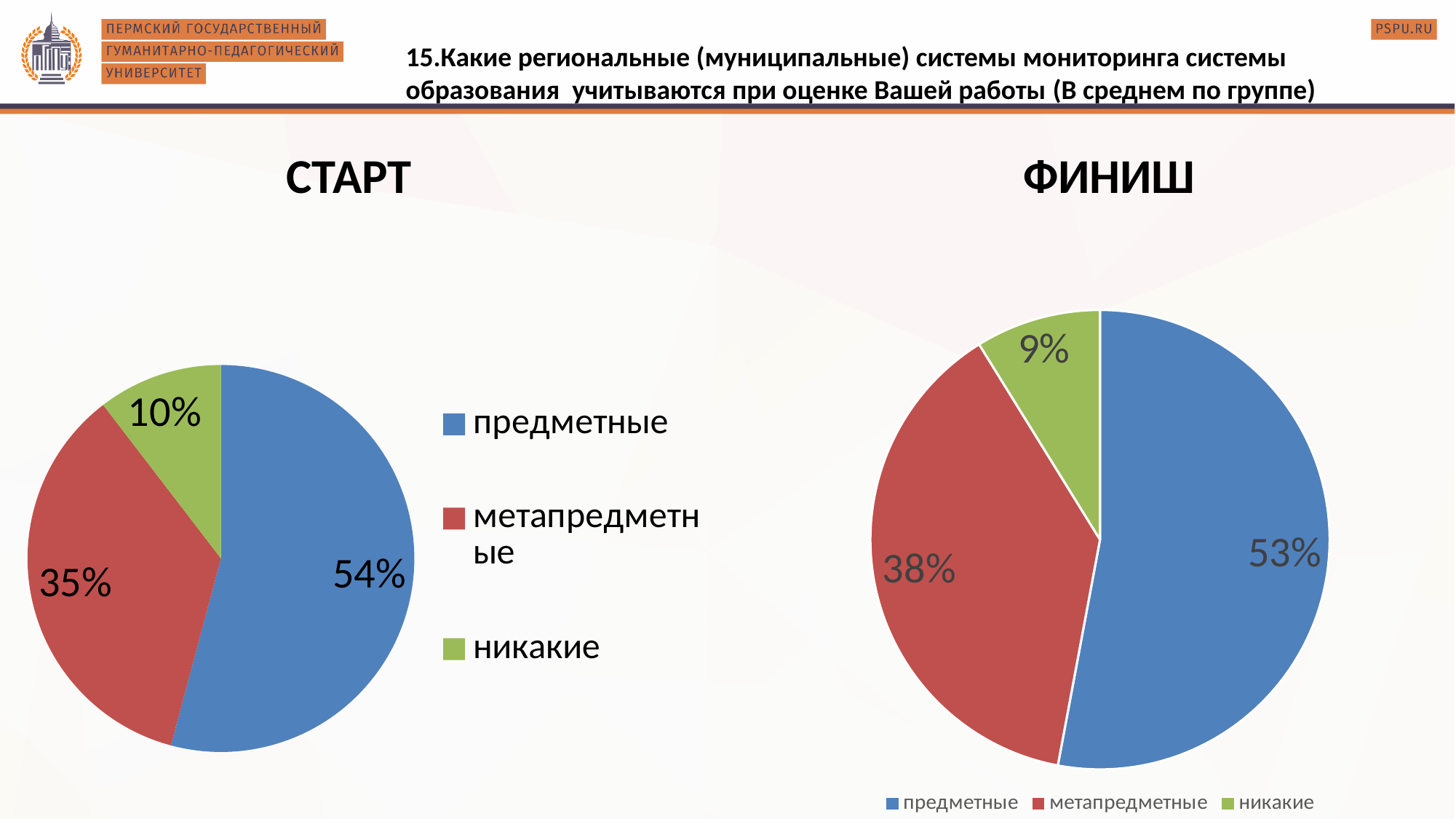
How many entries does the legend of the ФИНИШ chart list? 3 In the ФИНИШ pie chart, what share is shown for метапредметные? 38% In the ФИНИШ pie chart, what is the difference between the shares of предметные and никакие? 44% In the СТАРТ pie chart, what is the difference between the shares of предметные and метапредметные? 19% In the ФИНИШ pie chart, which category has the smallest slice? никакие In the СТАРТ pie chart, what share is shown for метапредметные? 35% In the СТАРТ pie chart, what share is shown for предметные? 54% In the ФИНИШ pie chart, what share is shown for никакие? 9% How many slices does the ФИНИШ pie chart have? 3 What type of chart is used for СТАРТ? Pie chart Which chart shows a larger share for метапредметные, СТАРТ or ФИНИШ? ФИНИШ In the СТАРТ pie chart, which category has the largest slice? предметные